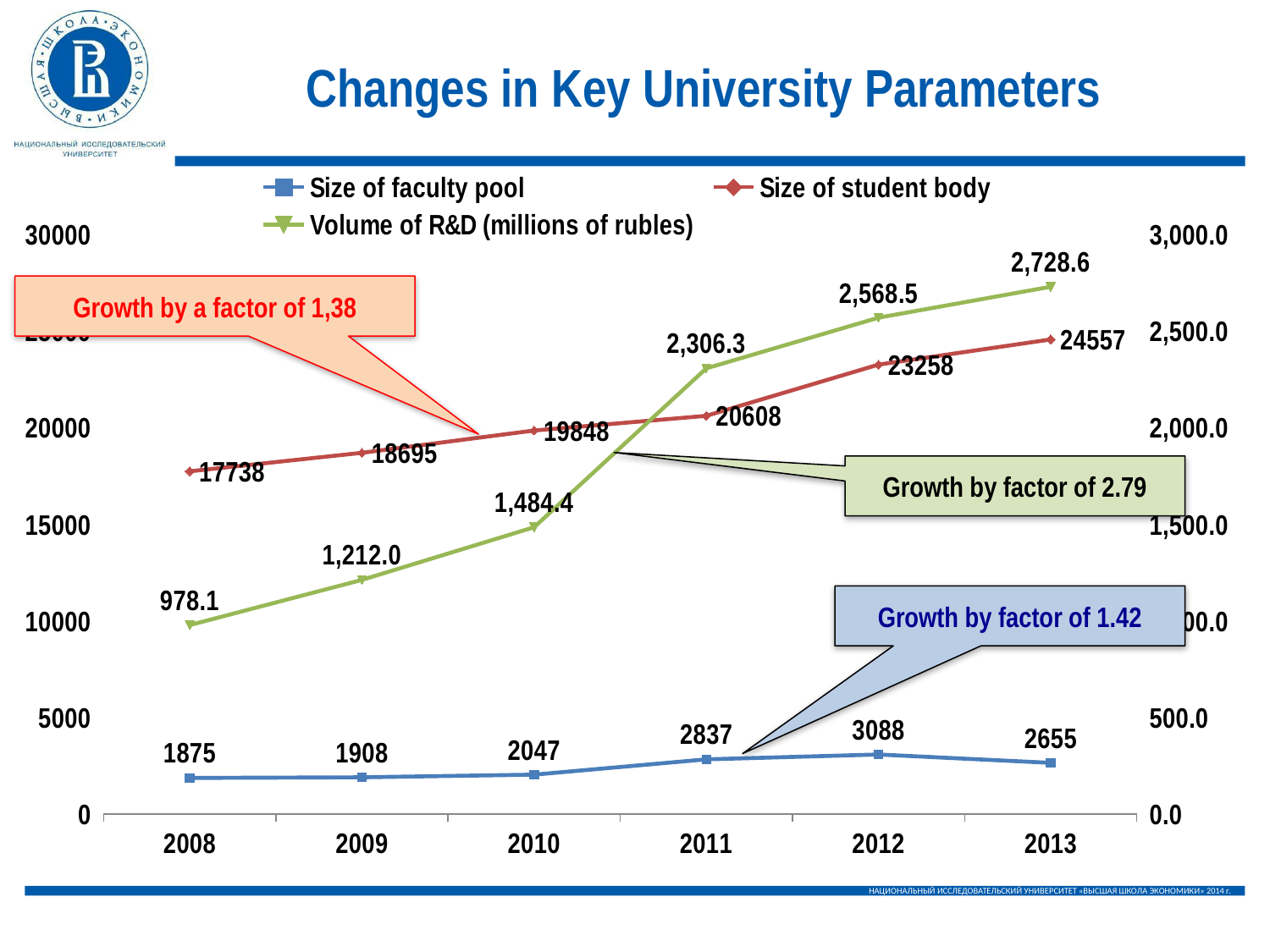
How many years are shown on the x axis? 6 What was the size of the faculty pool in 2011? 2837 What was the size of the student body in 2013? 24557 What kind of chart is shown on the slide? Line chart Which was larger, the size of the faculty pool in 2011 or in 2013? 2011 What is the difference between the faculty pool in 2012 and in 2013? 433 How many series does the legend list? 3 In which year was the volume of R&D lowest? 2008 Does the size of the student body rise or fall from 2008 to 2013? Rise In which year was the size of the faculty pool highest? 2012 By how much did the size of the student body increase from 2008 to 2013? 6819 What was the volume of R&D (millions of rubles) in 2010? 1,484.4